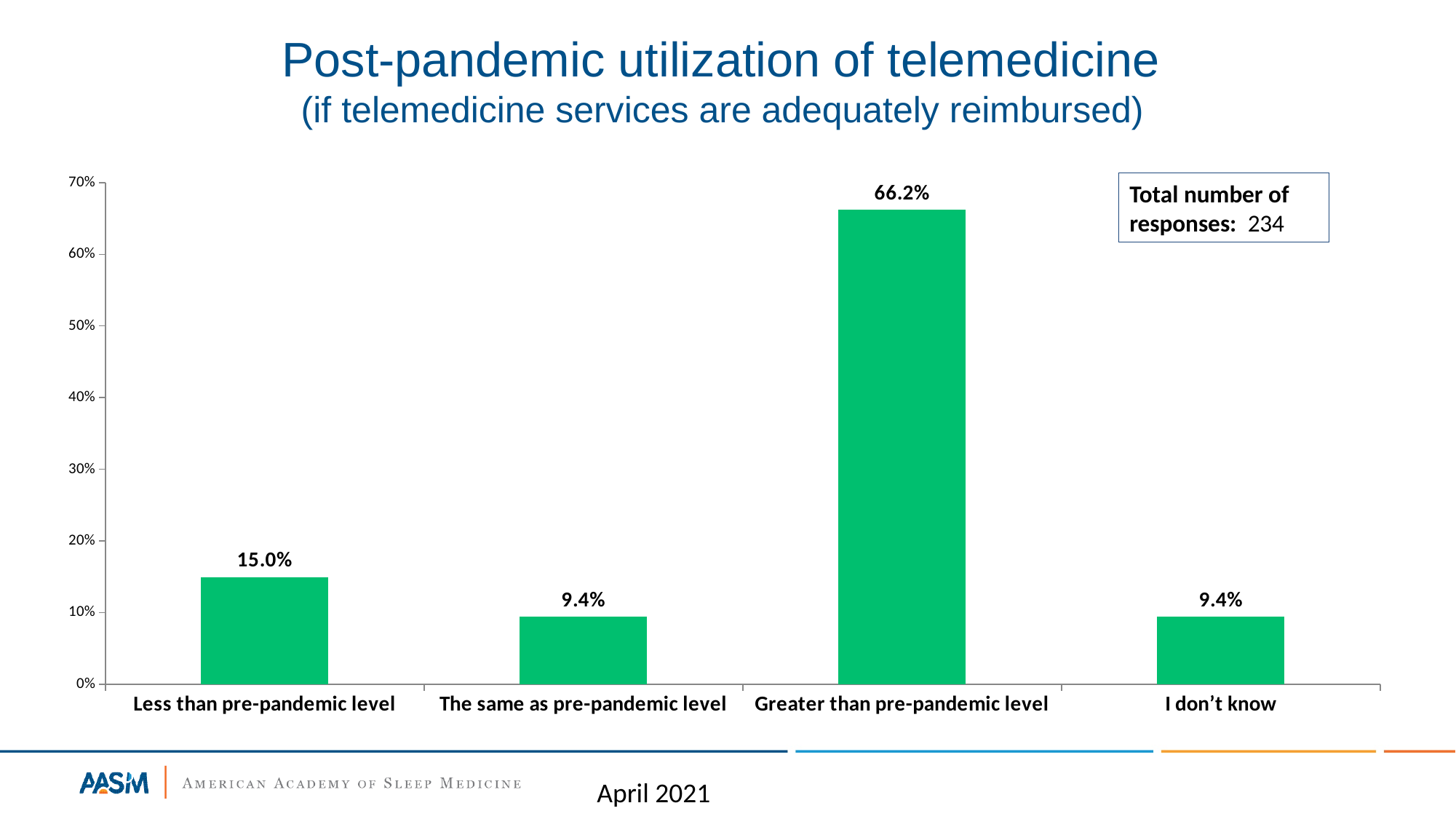
What kind of chart is shown on the slide? bar chart Which is larger, the value for 'Less than pre-pandemic level' or 'The same as pre-pandemic level'? Less than pre-pandemic level What is the value for 'Less than pre-pandemic level'? 15.0% What percentage of respondents expect post-pandemic telemedicine utilization to be greater than pre-pandemic level? 66.2% Which category has the highest value? Greater than pre-pandemic level What is the difference between the values for 'Less than pre-pandemic level' and 'The same as pre-pandemic level'? 5.6% What is the total number of responses stated on the slide? 234 How many categories are shown on the x axis? 4 What is the difference between the values for 'Greater than pre-pandemic level' and 'Less than pre-pandemic level'? 51.2% Is the value for 'Greater than pre-pandemic level' greater or less than 60%? greater What is the value for 'I don't know'? 9.4% What is the value for 'The same as pre-pandemic level'? 9.4%